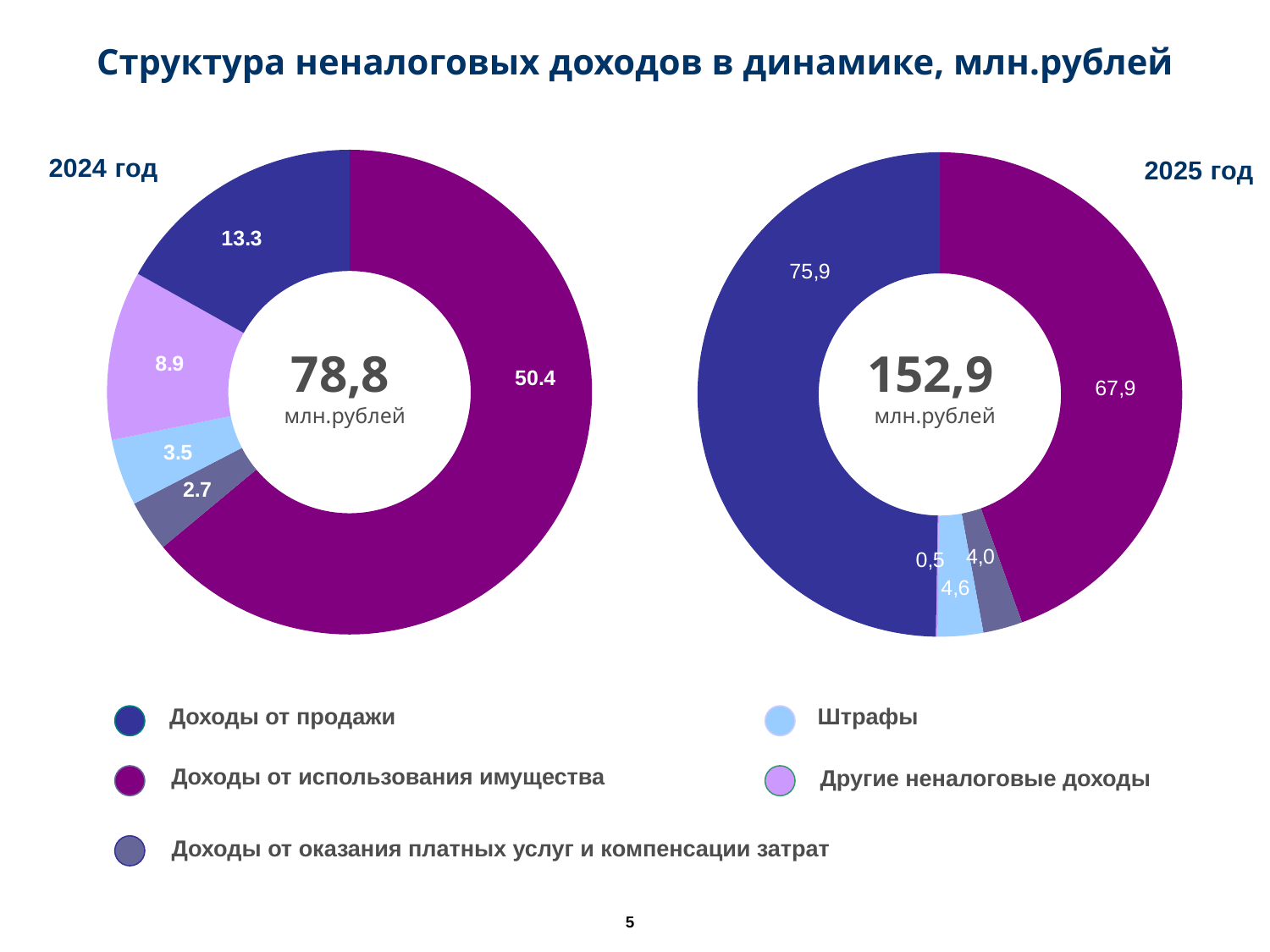
What is the total shown in the centre of the 2025 год chart? 152,9 млн.рублей In the 2024 год chart, which category has the largest value? Доходы от использования имущества In the 2025 год chart, what is the difference between Доходы от продажи and Доходы от использования имущества? 8,0 In the 2025 год chart, which category has the smallest value? Другие неналоговые доходы In the 2024 год chart, what share of the total 78,8 does Доходы от использования имущества (50.4) represent, rounded to the nearest percent? 64% What kind of chart is used for the 2024 год data? Donut (pie) chart How many categories does the legend list? 5 In the 2024 год chart, what is the value for Штрафы? 3.5 In the 2025 год chart, what is the value for Другие неналоговые доходы? 0,5 In the 2025 год chart, what is the value for Доходы от продажи? 75,9 In the 2024 год chart, what is the value for Доходы от использования имущества? 50.4 In the 2024 год chart, which is larger: Доходы от продажи or Другие неналоговые доходы? Доходы от продажи